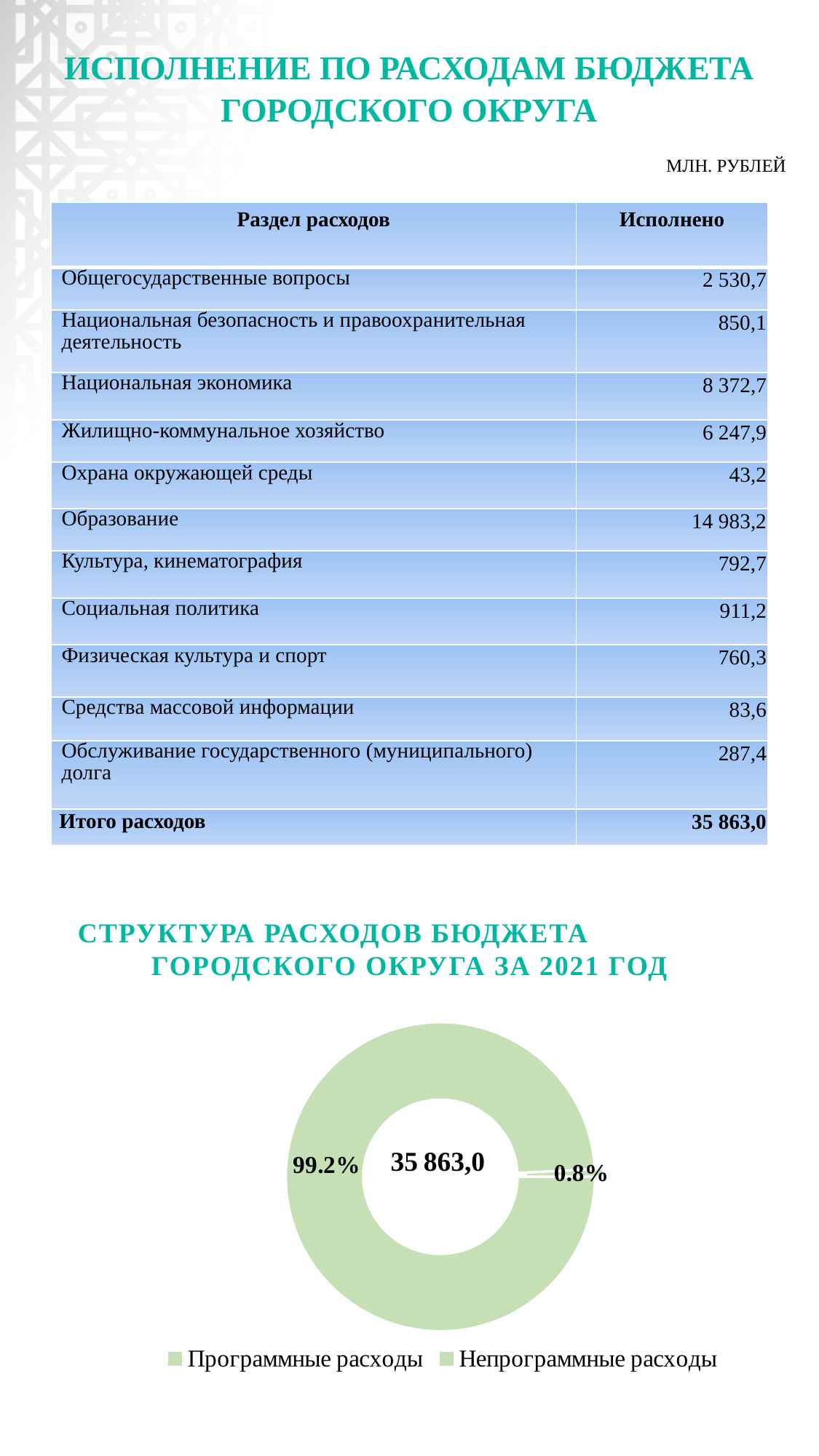
In the doughnut chart, which is larger: Программные расходы or Непрограммные расходы? Программные расходы How many categories does the legend of the doughnut chart list? 2 In the doughnut chart, what share is labelled for Непрограммные расходы? 0.8% Which category has the smallest slice in the doughnut chart? Непрограммные расходы What is the title of the doughnut chart on the slide? СТРУКТУРА РАСХОДОВ БЮДЖЕТА ГОРОДСКОГО ОКРУГА ЗА 2021 ГОД In the doughnut chart, what share is labelled for Программные расходы? 99.2% Is the share for Программные расходы in the doughnut chart greater or less than 50%? greater What is the difference in percentage points between the two slices of the doughnut chart? 98.4 What are the two legend entries of the doughnut chart? Программные расходы, Непрограммные расходы What value is printed in the centre of the doughnut chart? 35 863,0 What kind of chart is shown under the title 'СТРУКТУРА РАСХОДОВ БЮДЖЕТА ГОРОДСКОГО ОКРУГА ЗА 2021 ГОД'? Doughnut (pie) chart Which category has the largest slice in the doughnut chart? Программные расходы